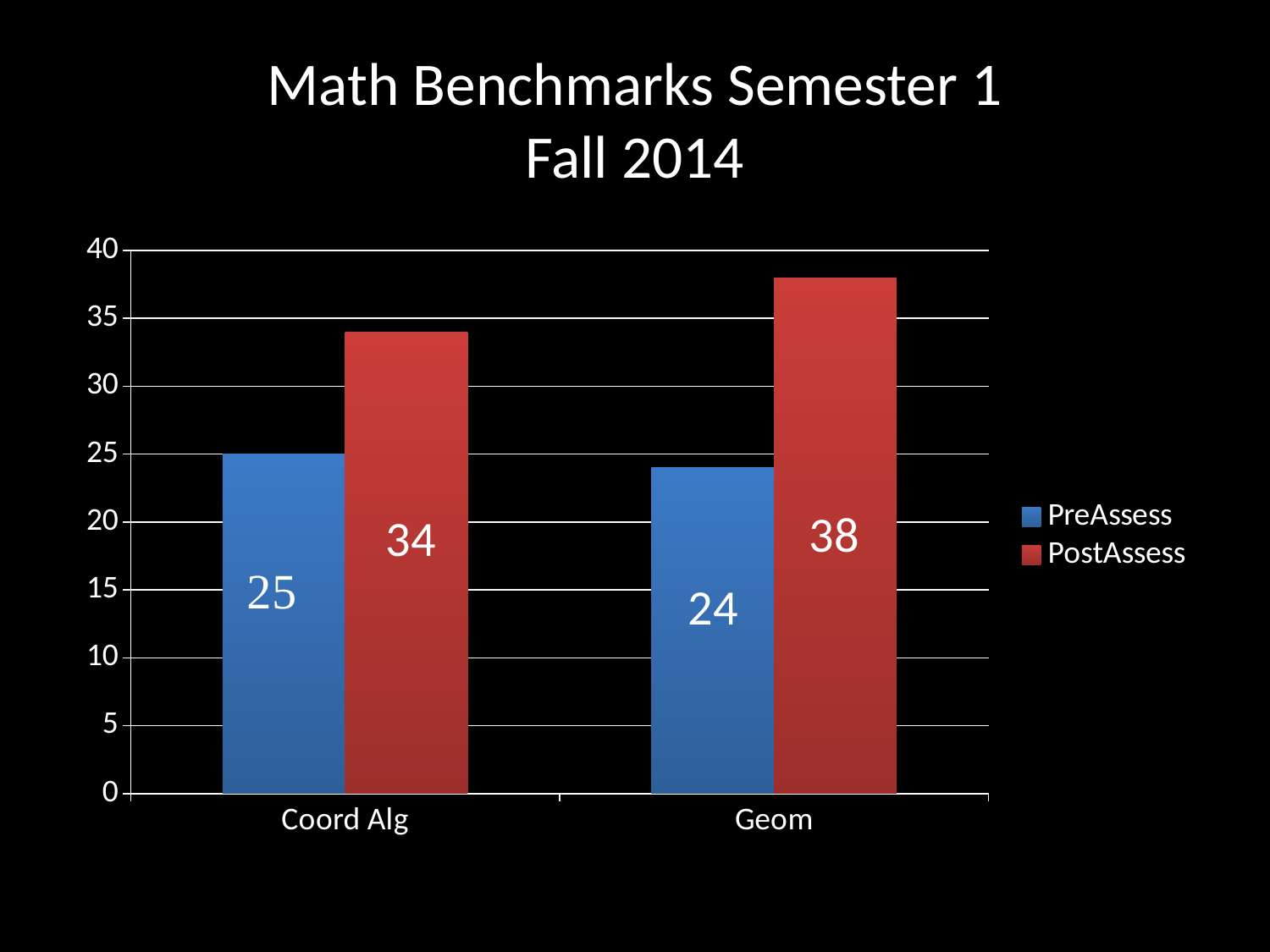
What is the PreAssess value for Coord Alg? 25 Which category has the highest PostAssess value? Geom What kind of chart is shown on the slide? Bar chart Which is larger, the PostAssess value for Coord Alg or the PostAssess value for Geom? PostAssess for Geom What is the difference between the PostAssess and PreAssess values for Geom? 14 What is the difference between the PostAssess and PreAssess values for Coord Alg? 9 What is the PreAssess value for Geom? 24 How many categories are shown on the x axis? 2 What is the PostAssess value for Geom? 38 What is the PostAssess value for Coord Alg? 34 Which bar has the lowest value on the chart? PreAssess for Geom How many series does the legend list? 2